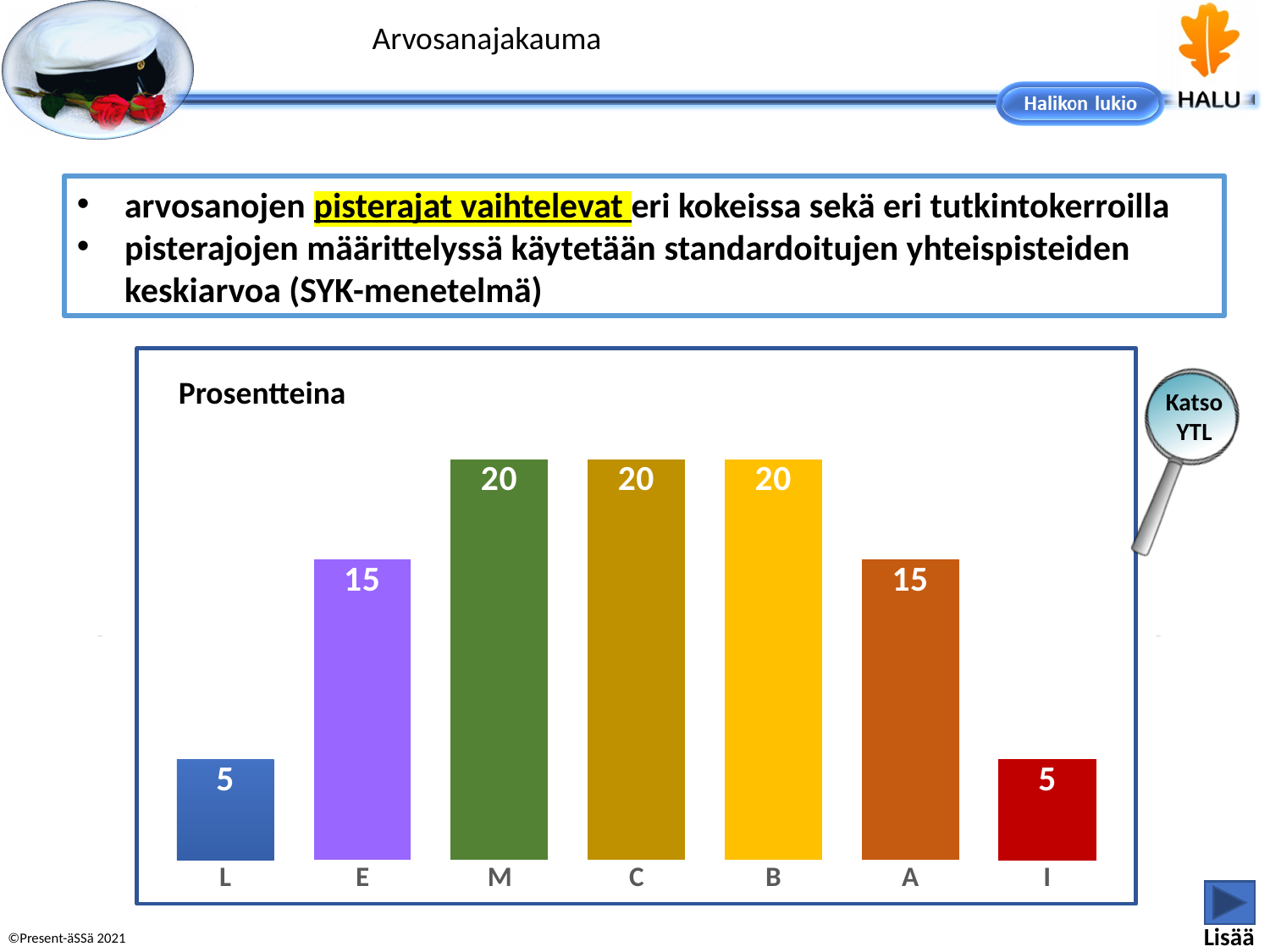
What is the value for category I? 5 Which categories have the lowest value? L and I What is the value for category E? 15 What is the title of the chart? Prosentteina Which is larger, the value for C or the value for A? C What is the difference between the values for E and I? 10 What kind of chart is shown? Bar chart What is the difference between the values for M and L? 15 What is the value for category A? 15 How many categories are shown on the x axis? 7 What is the value for category M? 20 Which categories share the highest value? M, C and B